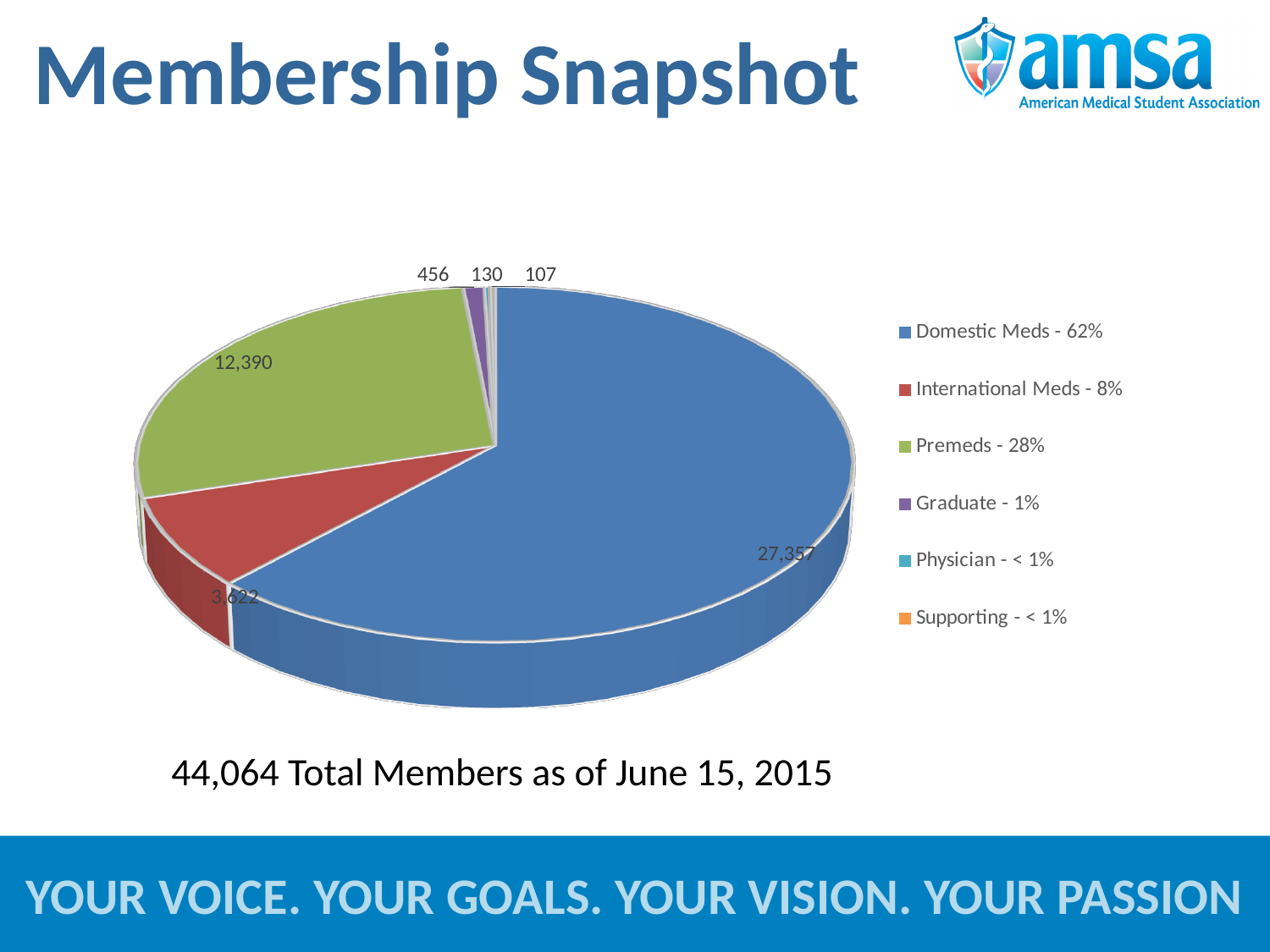
Which category has the smallest slice of the pie? Supporting What share of the pie does Premeds represent, according to the legend? 28% How many members are in the Domestic Meds category? 27,357 How many categories does the legend list? 6 What kind of chart is shown on the slide? Pie chart How many members are in the Graduate category? 456 How many members are in the Premeds category? 12,390 What is the difference between the Domestic Meds and Premeds member counts? 14,967 What is the difference between the Graduate and Physician member counts? 326 Which category has the largest slice of the pie? Domestic Meds How many members are in the Supporting category? 107 How many members are in the Physician category? 130